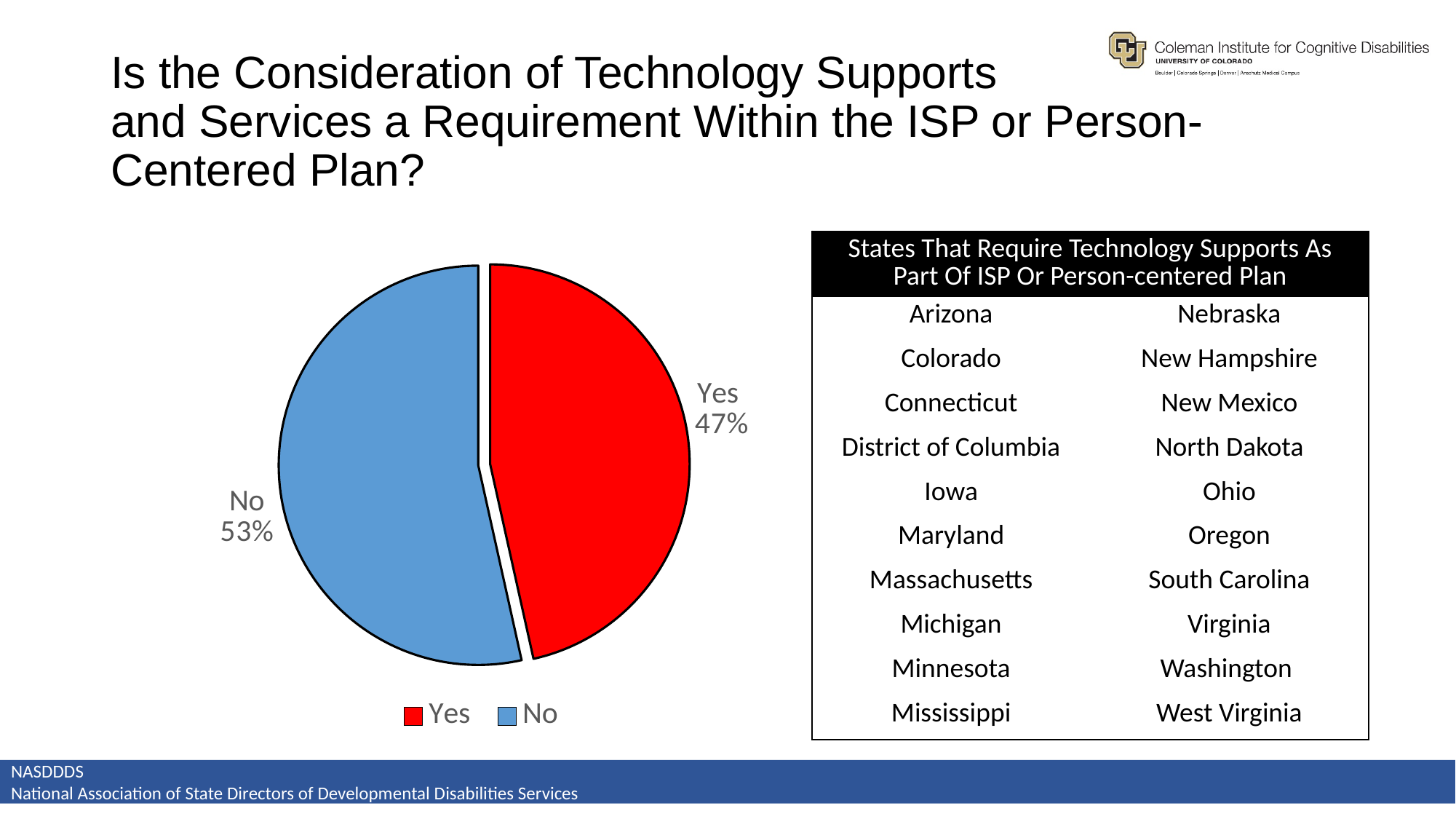
What colour is the "No" slice in the pie chart? blue How many slices does the pie chart have? 2 What percentage of the pie chart is labelled "Yes"? 47% Which slice of the pie chart is the largest? No What type of chart is shown on the slide? pie chart Which is larger in the pie chart, the "Yes" slice or the "No" slice? No What is the share of the pie chart taken by the "Yes" slice? 47% What percentage of the pie chart is labelled "No"? 53% How many entries does the pie chart's legend list? 2 Which slice of the pie chart is the smallest? Yes What is the difference in percentage points between the "No" slice and the "Yes" slice? 6 What colour is the "Yes" slice in the pie chart? red